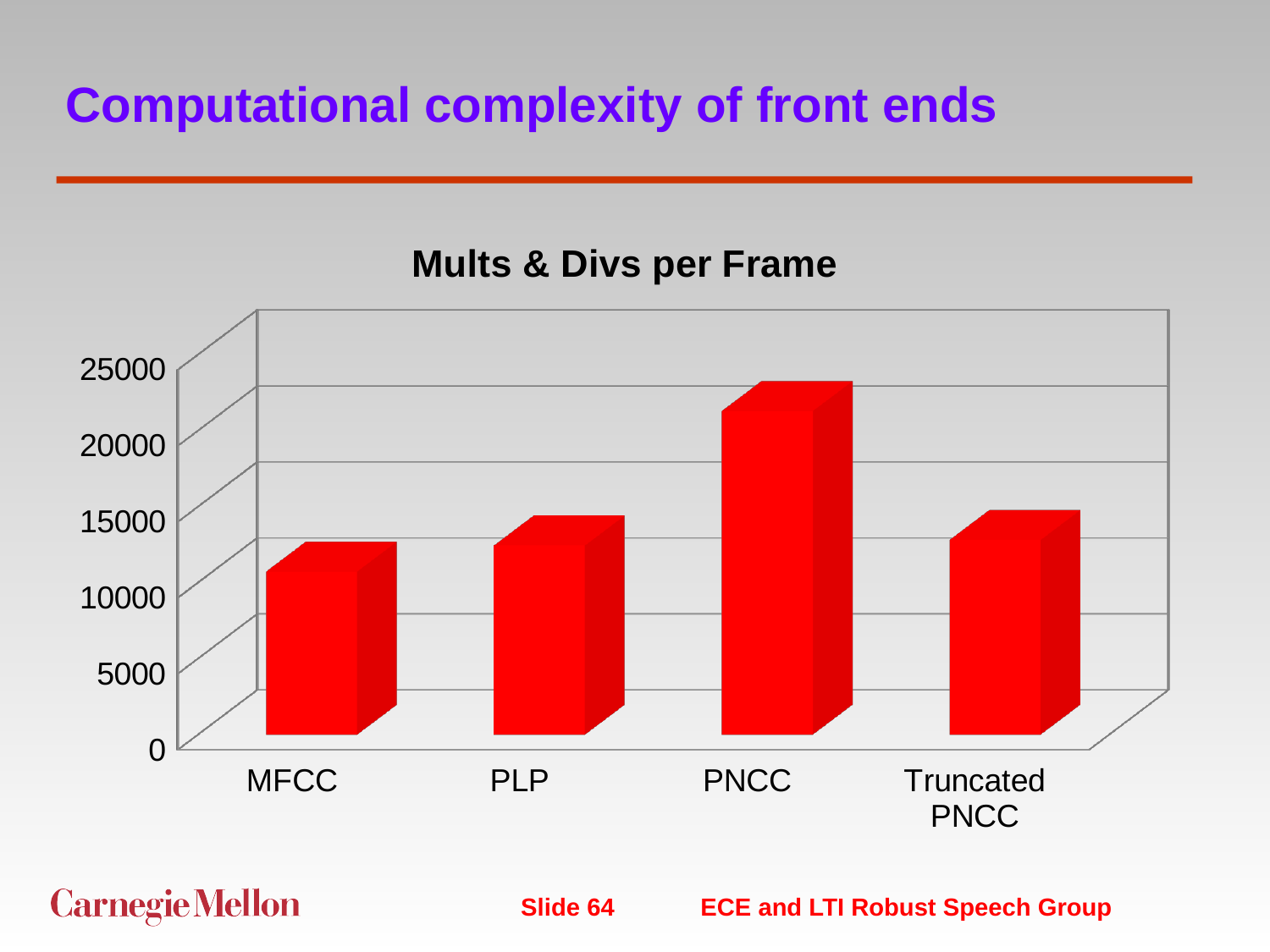
How many front ends (categories) are plotted in the chart? 4 What is the title of the chart? Mults & Divs per Frame Which has more mults & divs per frame, PNCC or MFCC? PNCC What kind of chart is shown on the slide? bar chart Which front end has the lowest number of mults & divs per frame? MFCC Is the value for MFCC greater or less than 10000? greater Which front end has the highest number of mults & divs per frame? PNCC What colour are the bars in the chart? red Is the value for PNCC greater or less than 20000? greater Is the value for PNCC greater or less than 25000? less